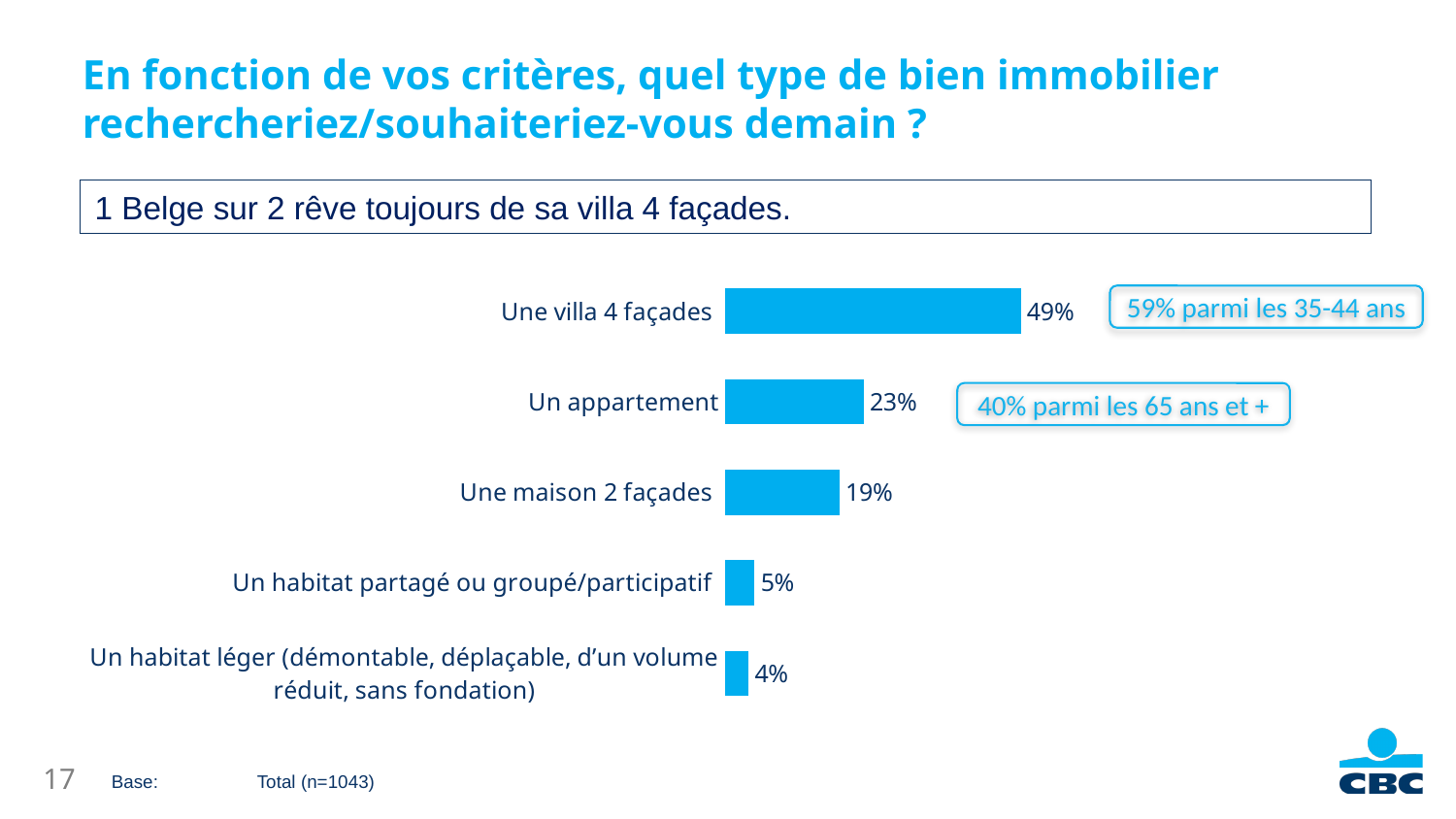
What is the difference between the values for "Une villa 4 façades" and "Un appartement"? 26% According to the callout next to the top bar, what percentage of 35-44 year olds chose "Une villa 4 façades"? 59% What percentage is shown for "Une maison 2 façades"? 19% How many categories are shown in the chart? 5 What is the base (sample size) stated at the bottom of the slide? Total (n=1043) Which is larger: the value for "Un appartement" or for "Une maison 2 façades"? Un appartement Which category has the lowest value in the chart? Un habitat léger (démontable, déplaçable, d'un volume réduit, sans fondation) Which category has the highest value in the chart? Une villa 4 façades What is the value shown for "Un appartement"? 23% What percentage of respondents chose "Une villa 4 façades"? 49% What is the value for "Un habitat partagé ou groupé/participatif"? 5% What kind of chart is shown on the slide? Bar chart